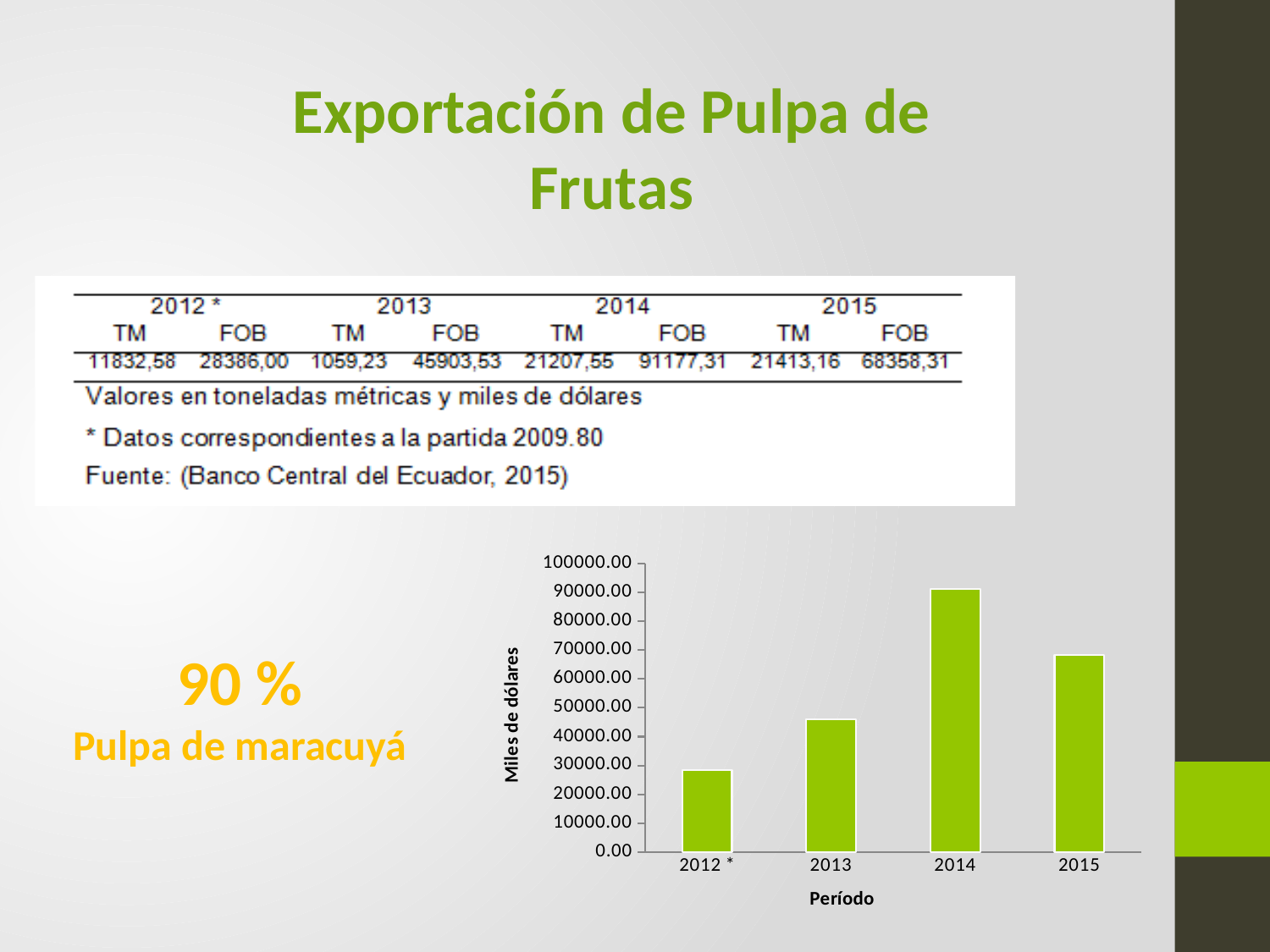
Which period has the lowest value in the chart? 2012 * How many periods (bars) are plotted in the chart? 4 What kind of chart is shown on the slide? bar chart Is the value for 2012 * in the chart greater or less than 20000.00? greater Which period has the highest value in the chart? 2014 Is the value for 2014 in the chart greater or less than 80000.00? greater Is the value for 2015 in the chart greater or less than 70000.00? less What is the label of the horizontal axis of the chart? Período Do the values in the chart rise or fall from 2012 * to 2014? rise What is the label of the vertical axis of the chart? Miles de dólares Which is larger in the chart, the value for 2013 or the value for 2015? 2015